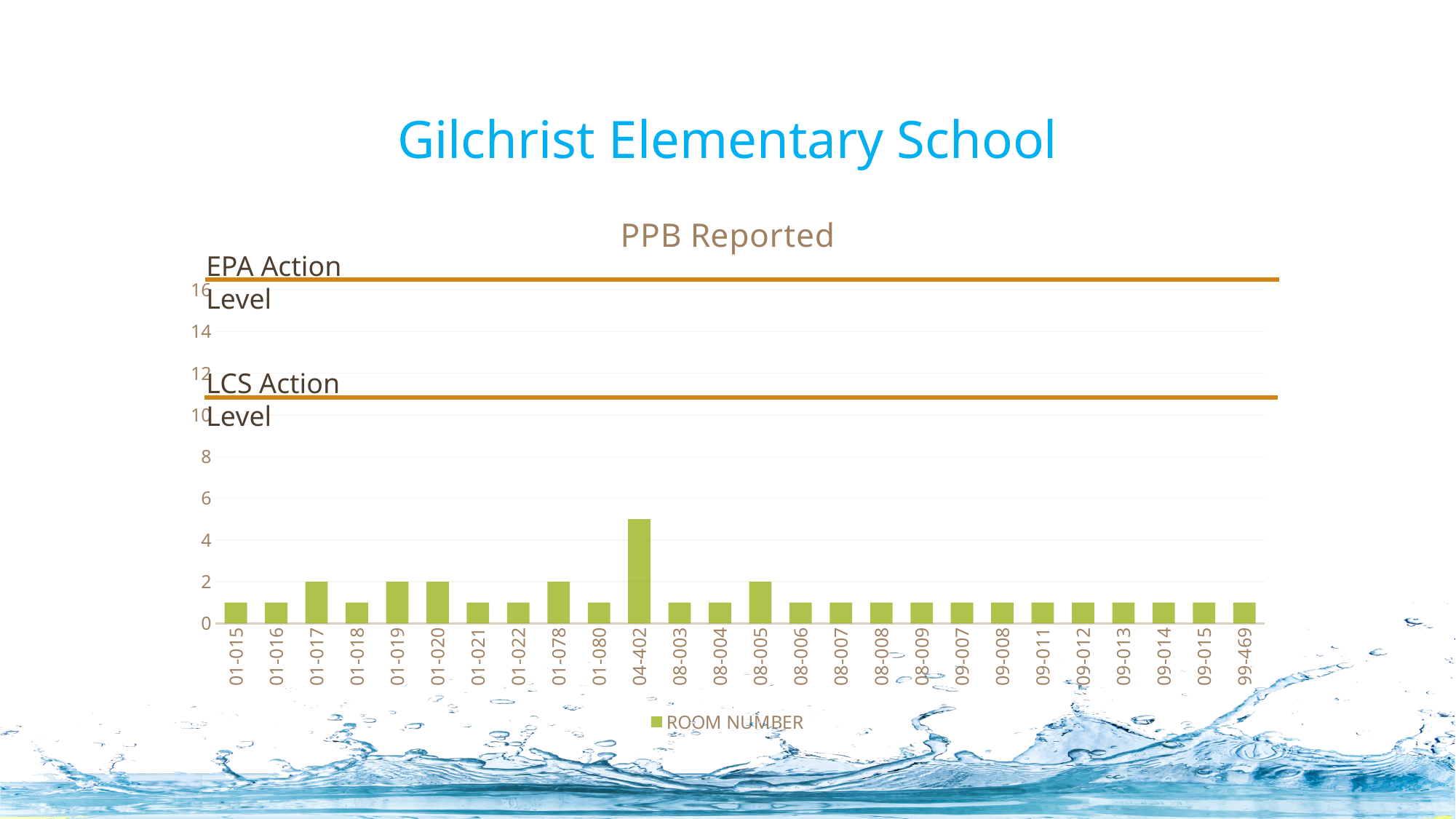
How many room numbers are plotted along the x axis? 26 Which room number has the highest PPB reported? 04-402 What is the name of the series shown in the legend? ROOM NUMBER What kind of chart is shown on the slide? bar chart What is the PPB reported value for room 01-017? 2 Which has a larger PPB reported value, room 01-017 or room 01-018? 01-017 Is the value for room 09-011 greater or less than 2? less What is the title of the chart? PPB Reported How many series does the legend list? 1 Is the value for room 04-402 greater or less than 4? greater What is the PPB reported value for room 08-005? 2 Which has a larger PPB reported value, room 04-402 or room 01-078? 04-402